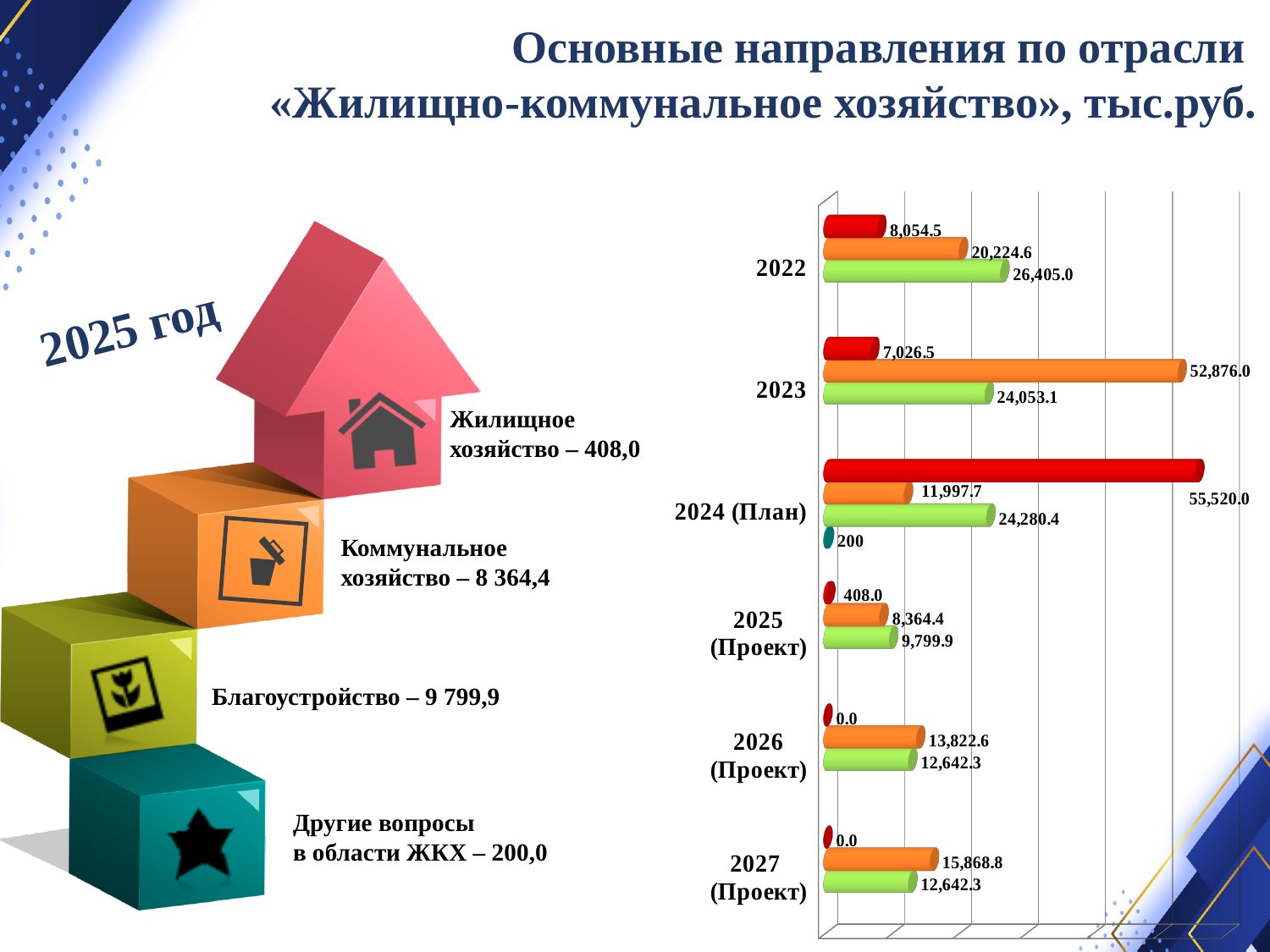
What is the title of the slide containing the chart? Основные направления по отрасли «Жилищно-коммунальное хозяйство», тыс.руб. In which year category is the orange bar the lowest? 2025 (Проект) What is the value of the red bar for 2022? 8,054.5 How many year categories are shown on the chart? 6 What is the value of the orange bar for 2027 (Проект)? 15,868.8 In which year category is the red bar the highest? 2024 (План) What type of chart is shown on the slide? bar chart What is the difference between the orange bar and the green bar for 2023? 28,822.9 What is the value of the orange bar for 2023? 52,876.0 Does the orange bar rise or fall from 2025 (Проект) to 2027 (Проект)? rise What is the value of the green bar for 2024 (План)? 24,280.4 For 2022, which is larger: the green bar or the orange bar? the green bar